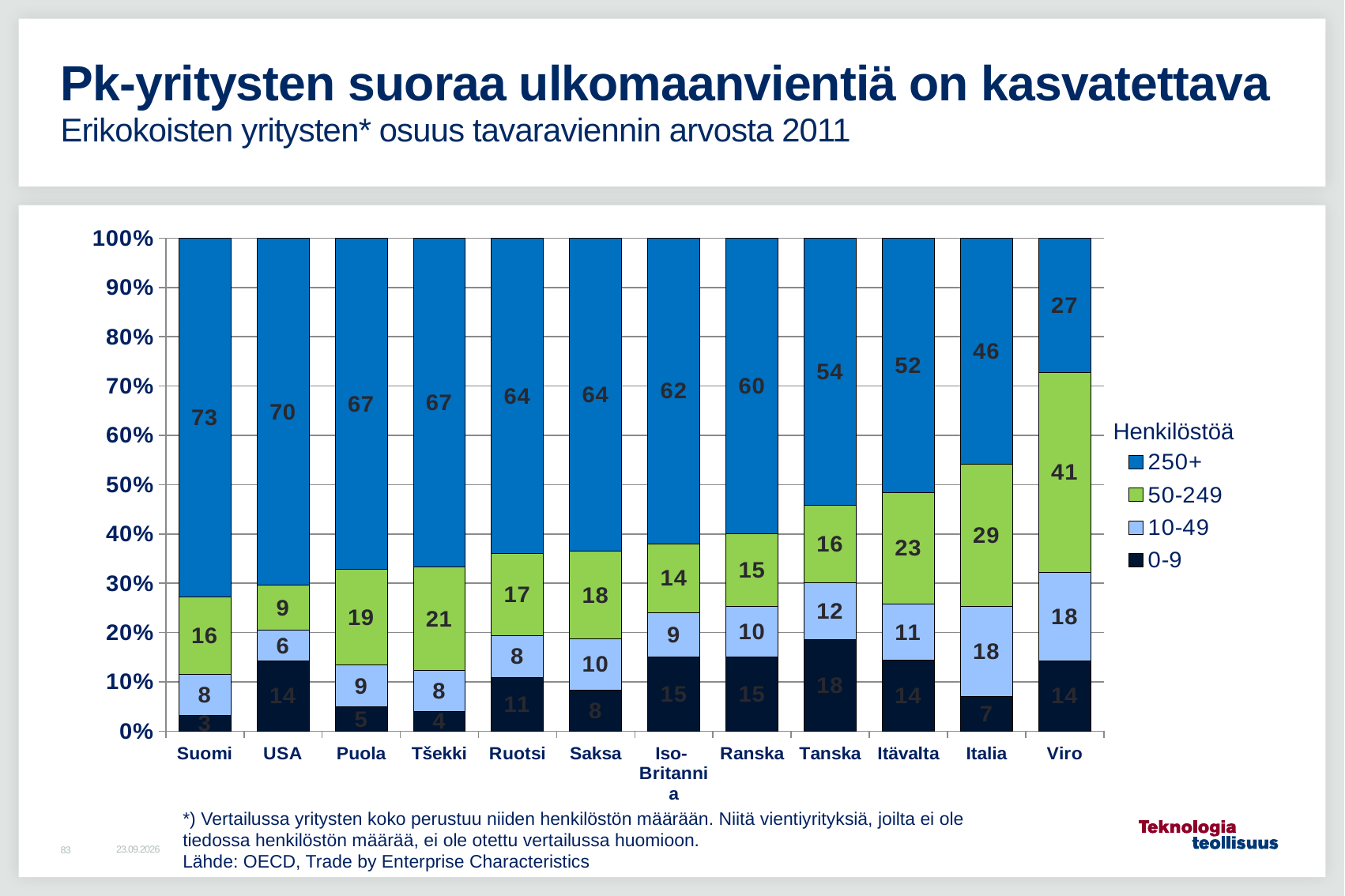
What is the value for the 0-9 series for Italia? 7 What is the value for the 50-249 series for Viro? 41 What is the value for the 10-49 series for Tanska? 12 How many countries are shown on the x axis? 12 What is the difference between the 250+ values for Suomi and Viro? 46 Which country has the lowest value for the 250+ series? Viro Which country has the highest value for the 250+ series? Suomi Which country has the highest value for the 50-249 series? Viro Which is larger, the 50-249 value for Italia or for Itävalta? Italia What is the value for the 250+ series for Suomi? 73 How many series does the legend list? 4 What kind of chart is shown on the slide? Stacked bar chart